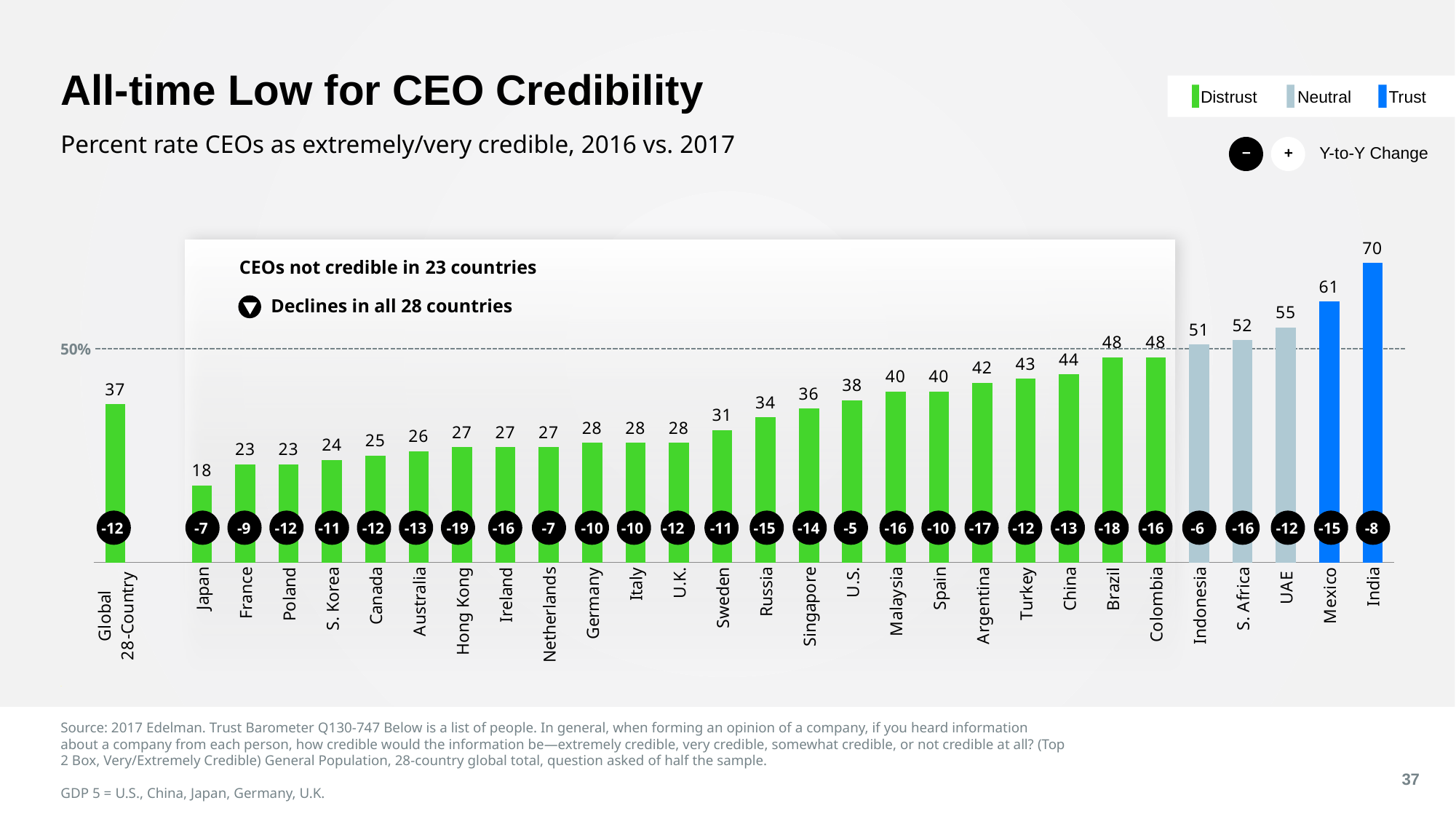
How many countries are shown in the chart, excluding the Global 28-Country bar? 28 What is the value shown for the Global 28-Country bar? 37 Is the value for Indonesia greater or less than 50%? greater Which legend category is shown in blue? Trust Which country has the lowest CEO credibility value? Japan How many categories does the legend list? 3 Which country has the highest CEO credibility value? India What is the difference between the values for India and Mexico? 9 What is the year-to-year change shown for Hong Kong? -19 Which has a higher CEO credibility value, the U.S. or Germany? U.S. What percent of respondents in Japan rate CEOs as extremely/very credible? 18 What kind of chart is shown on the slide? Bar chart